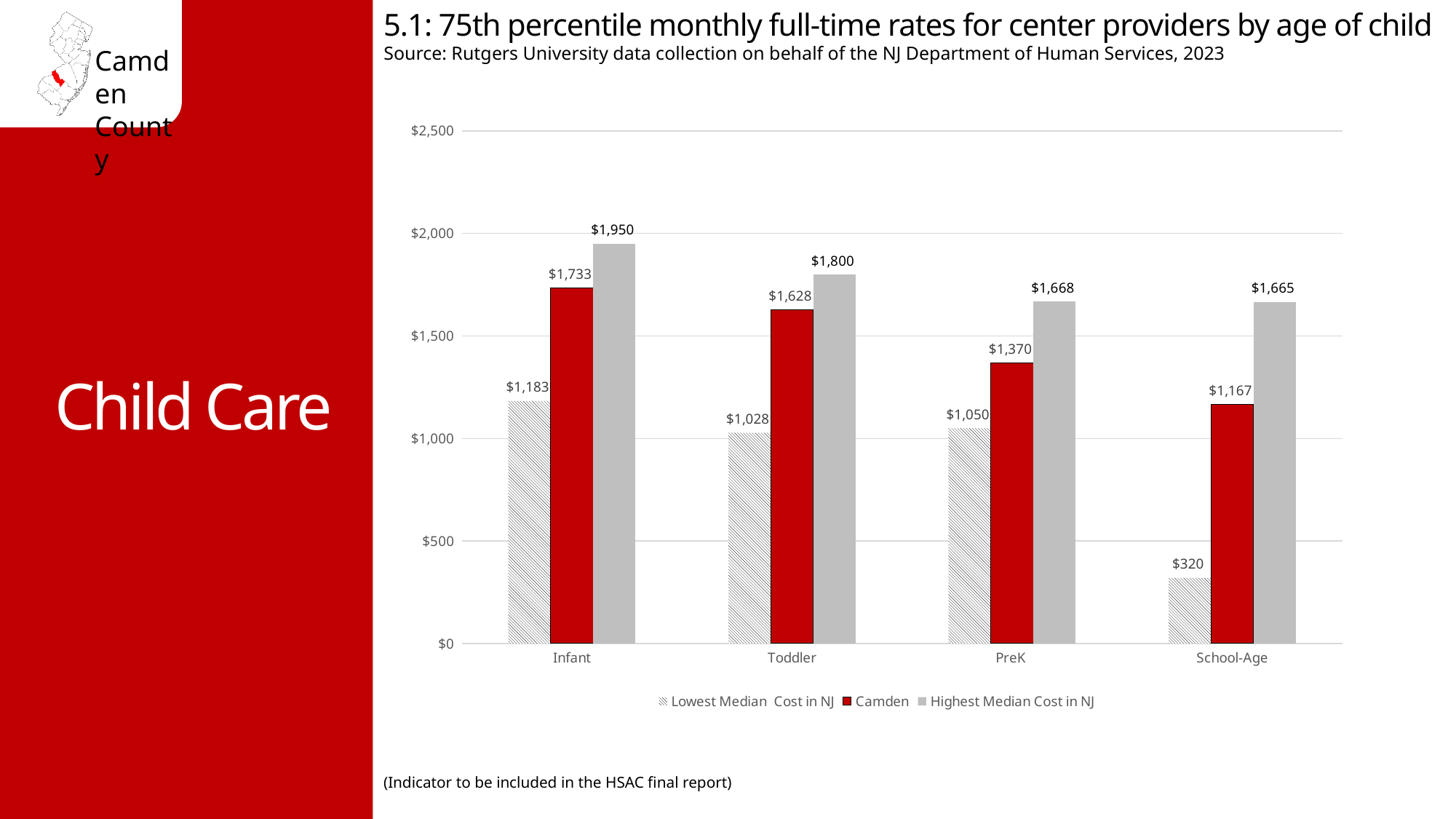
How many series does the legend list? 3 Is the Camden value for School-Age greater or less than $1,000? greater What is the difference between the Highest Median Cost in NJ and the Camden value for PreK? $298 Which age group has the highest Camden value? Infant What is the Lowest Median Cost in NJ for School-Age? $320 What kind of chart is shown on the slide? bar chart Which is larger for Toddler: the Camden value or the Lowest Median Cost in NJ value? Camden What is the Highest Median Cost in NJ for Toddler? $1,800 Which age group has the lowest Lowest Median Cost in NJ value? School-Age Does the Camden series rise or fall from Infant to School-Age? fall What is the Camden value for Infant? $1,733 How many age groups are shown on the x axis? 4